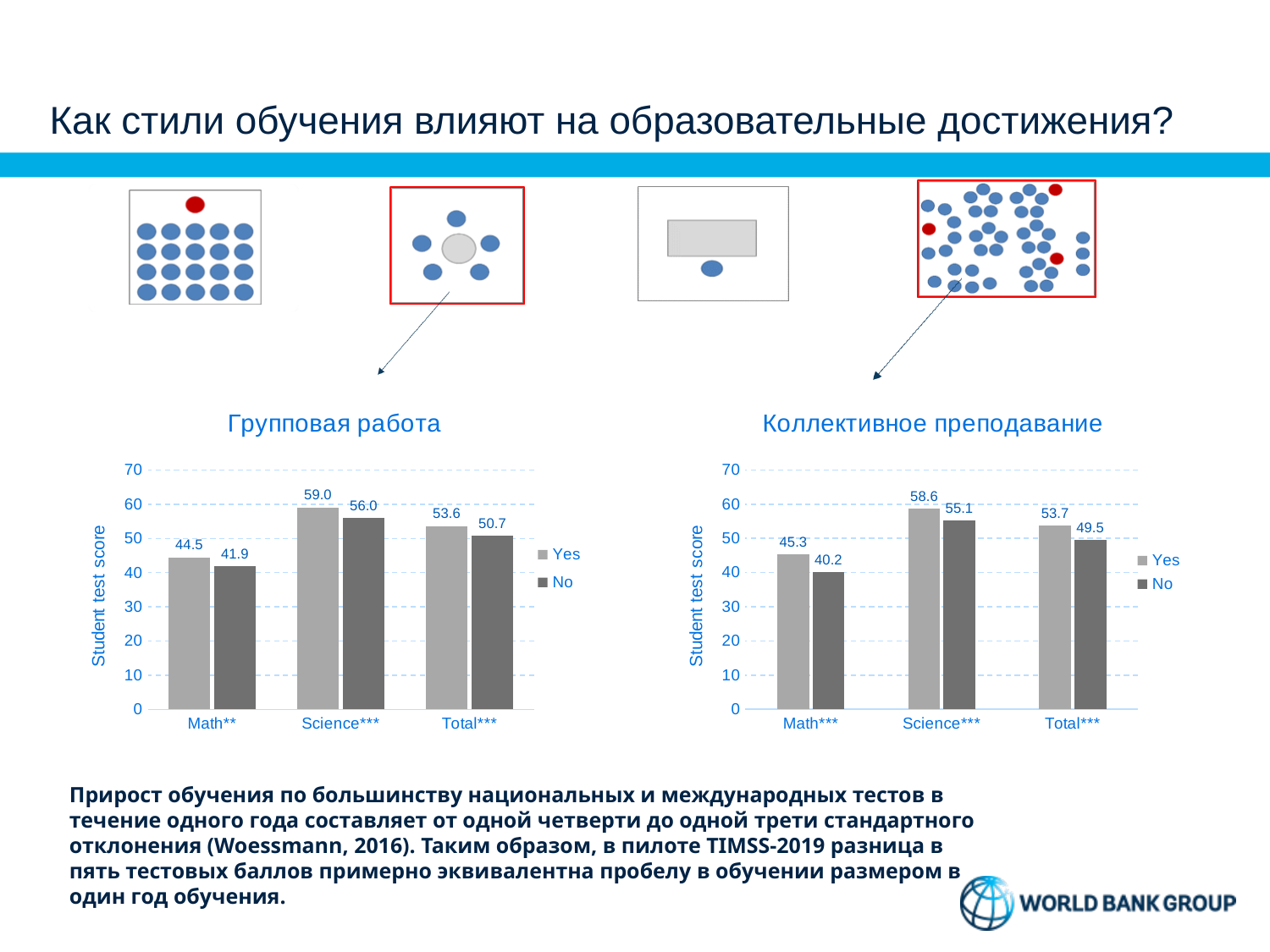
In the 'Коллективное преподавание' chart, which category has the lowest No value? Math*** In the 'Групповая работа' chart, what is the difference between the Yes and No values for Total***? 2.9 In the 'Коллективное преподавание' chart, which is larger for Science***: the Yes value or the No value? Yes In the 'Коллективное преподавание' chart, what is the value of the Yes series for Total***? 53.7 In the 'Групповая работа' chart, what is the value of the No series for Science***? 56.0 In the 'Коллективное преподавание' chart, what is the value of the No series for Math***? 40.2 How many categories are shown on the x axis of the 'Коллективное преподавание' chart? 3 In the 'Групповая работа' chart, which category has the highest Yes value? Science*** In the 'Групповая работа' chart, what is the value of the Yes series for Math**? 44.5 In the 'Коллективное преподавание' chart, what is the difference between the Yes and No values for Math***? 5.1 What type of chart is the 'Групповая работа' chart? Bar chart How many series does the legend of the 'Групповая работа' chart list? 2